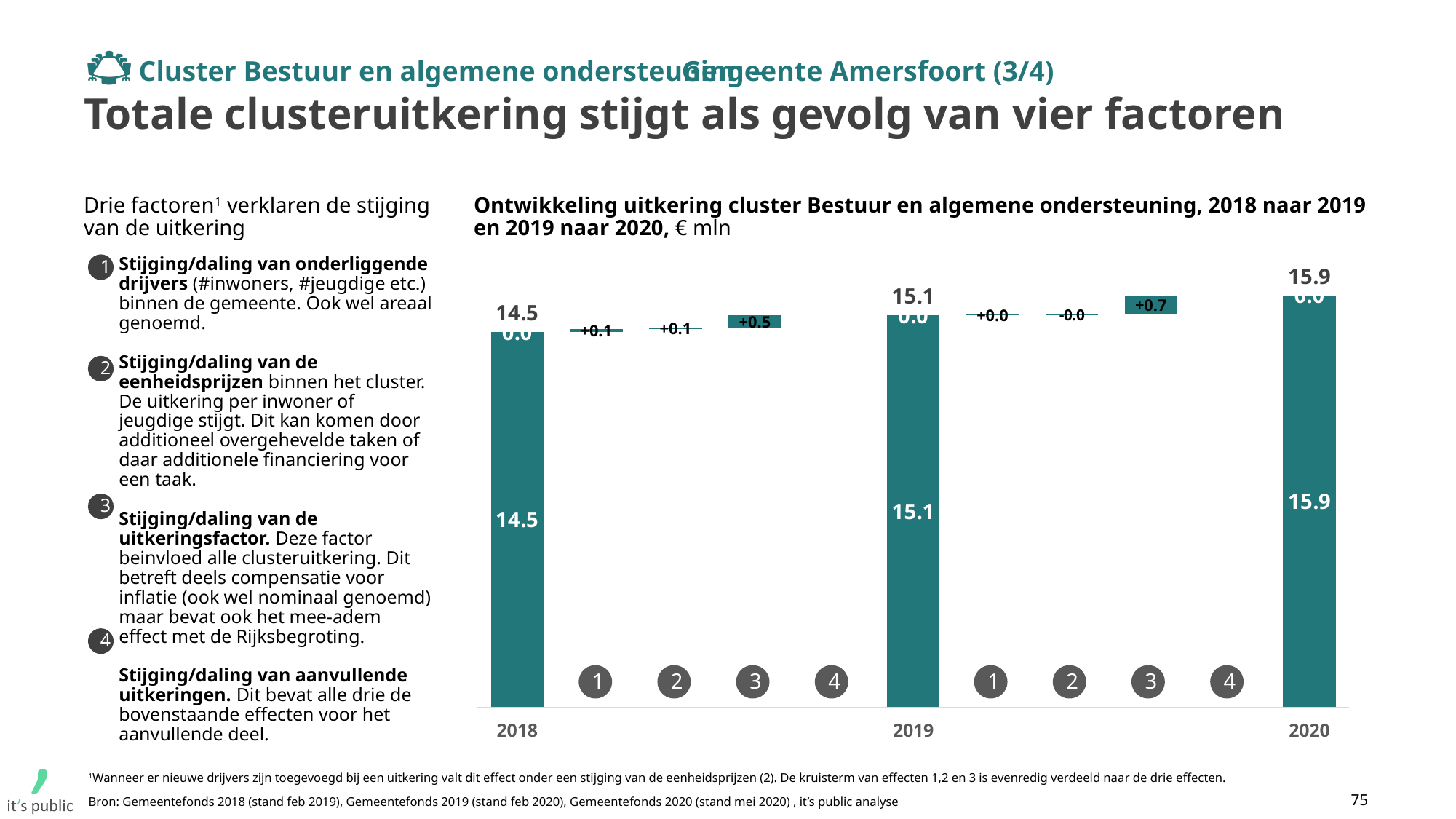
What is the value of factor 3 between 2018 and 2019? +0.5 Which year has the highest total uitkering value? 2020 What is the total uitkering value shown for 2019? 15.1 What is the total uitkering value shown for 2020? 15.9 In what unit are the values in the chart expressed? € mln What is the value of factor 3 between 2019 and 2020? +0.7 What is the total uitkering value shown for 2018? 14.5 What is the difference between the 2020 total and the 2018 total? 1.4 Is the factor 3 effect larger between 2018 and 2019 or between 2019 and 2020? Between 2019 and 2020 Which year has the lowest total uitkering value? 2018 Do the total uitkering values rise or fall from 2018 to 2020? Rise What is the value of factor 1 between 2018 and 2019? +0.1